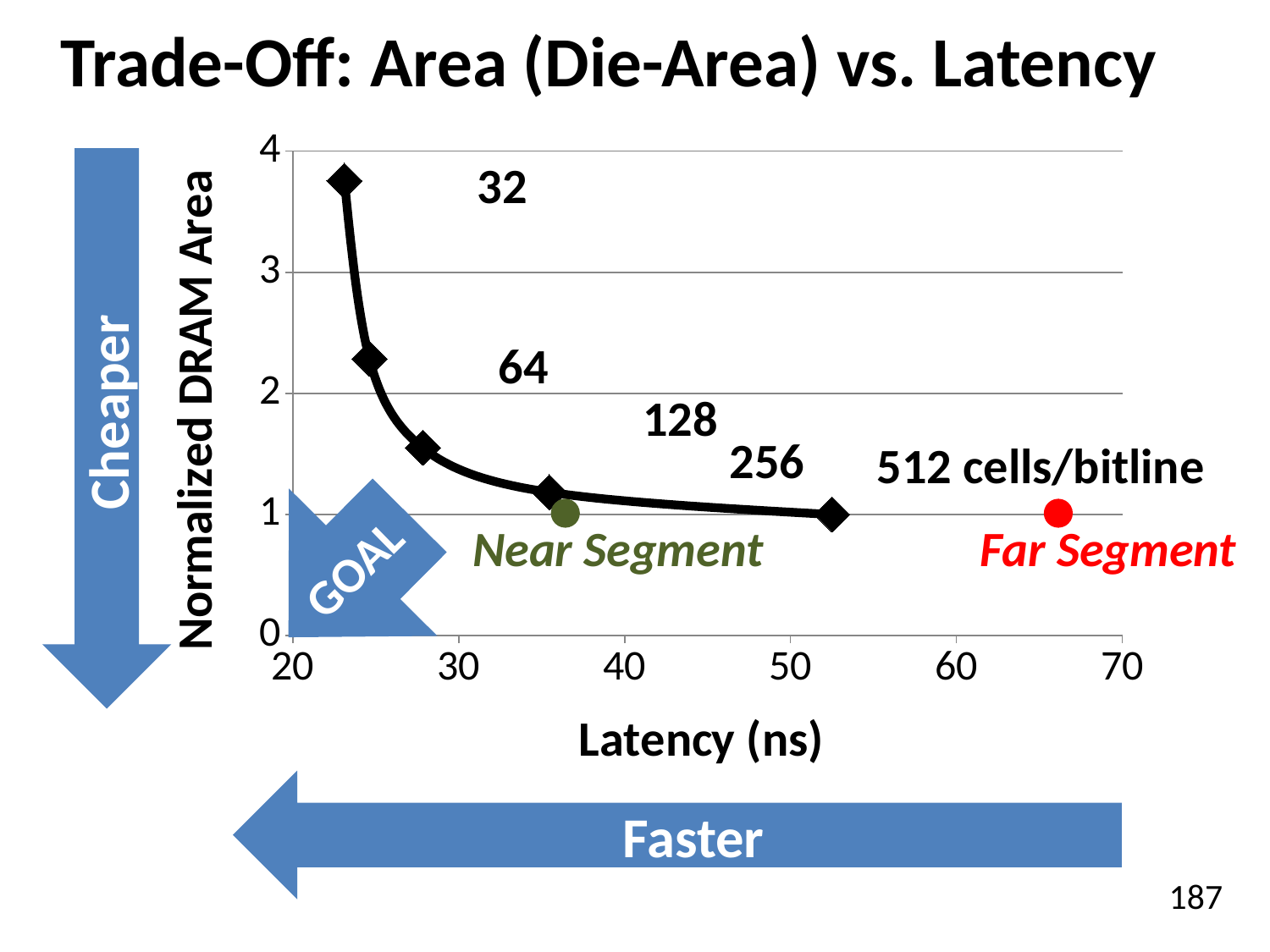
Is the normalized DRAM area for 32 cells/bitline greater or less than 3? greater What kind of chart is shown on the slide? line chart Is the normalized DRAM area for 64 cells/bitline greater or less than 2? greater How many black diamond data points are plotted on the curve? 5 Which cells/bitline configuration has the highest normalized DRAM area? 32 What is the title of the x axis? Latency (ns) Which cells/bitline configuration has the lowest normalized DRAM area? 512 Is the normalized DRAM area for 128 cells/bitline greater or less than 2? less As latency increases along the x axis, does the normalized DRAM area rise or fall? fall What colour is the Far Segment point? red